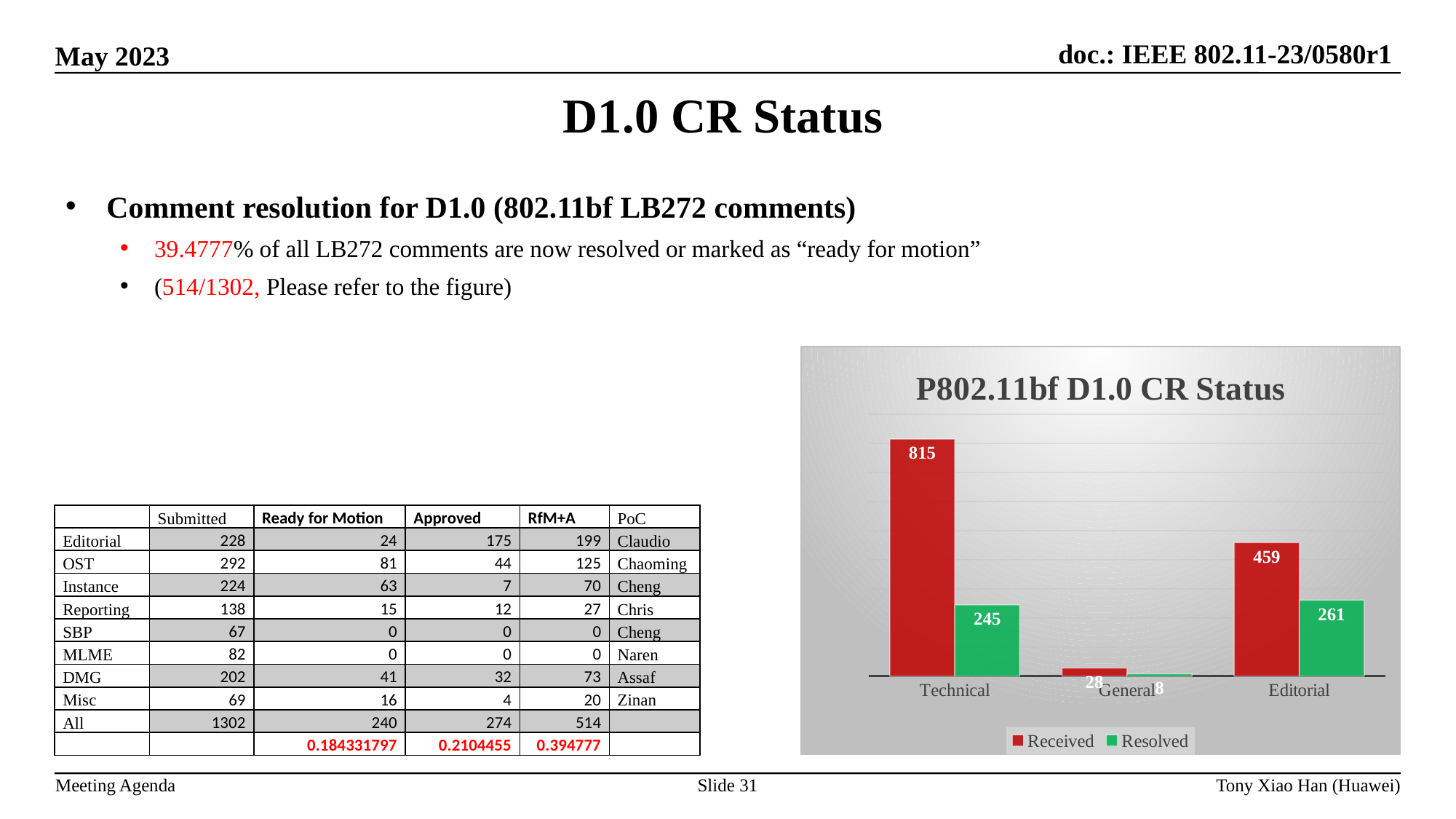
What is the Received value for Technical in the chart? 815 What is the Resolved value for Editorial in the chart? 261 What is the difference between the Received and Resolved values for Technical? 570 Which category has the lowest Resolved value in the chart? General What is the Received value for Editorial in the chart? 459 What is the Resolved value for Technical in the chart? 245 How many series does the chart legend list? 2 What type of chart is shown on the slide? bar chart Which category has the highest Received value in the chart? Technical Which is larger in the chart: the Resolved value for Editorial or the Resolved value for Technical? Resolved value for Editorial What is the title of the chart? P802.11bf D1.0 CR Status How many categories are shown on the x axis of the chart? 3